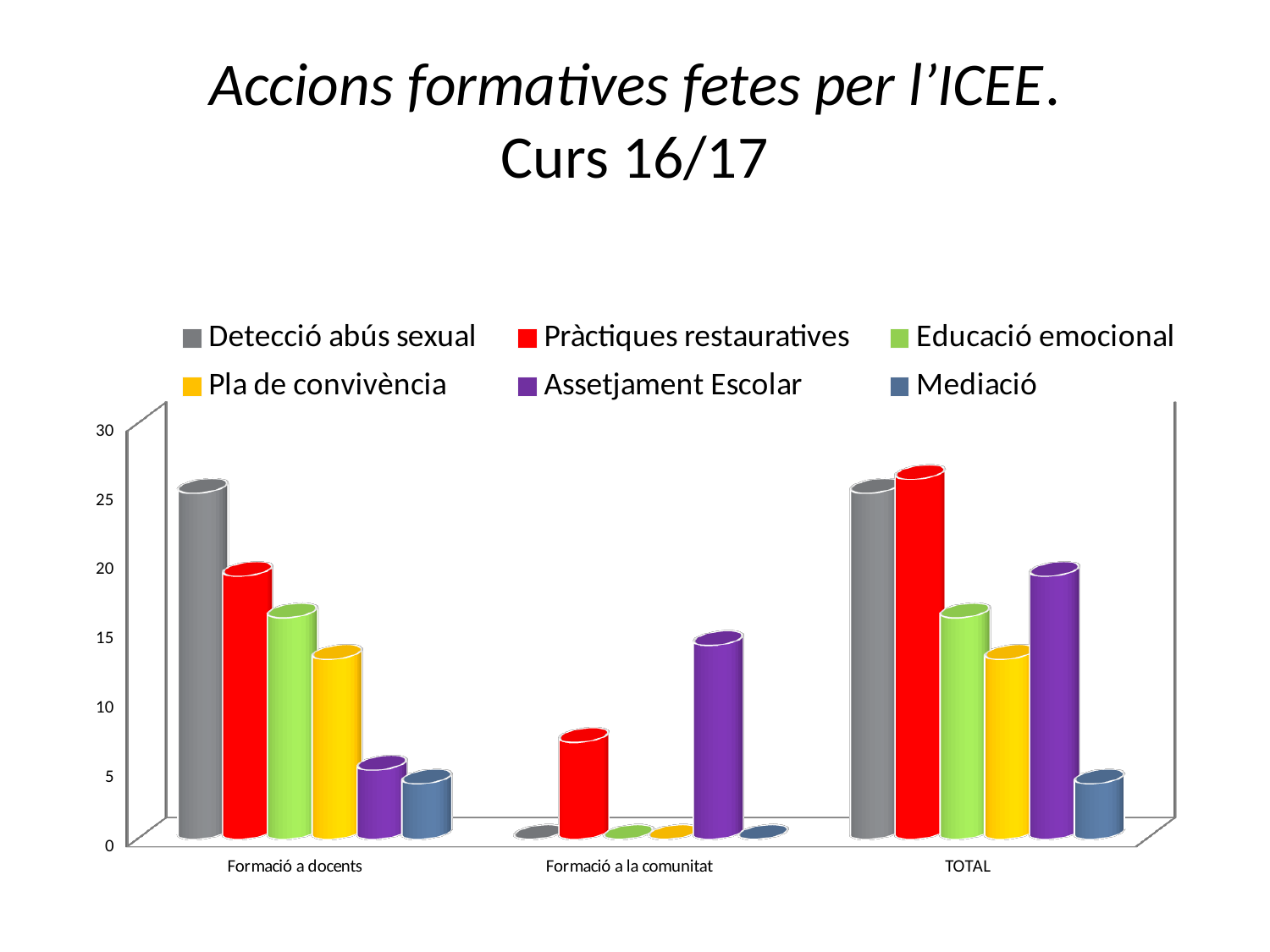
What kind of chart is shown on the slide? bar chart Is the value for Pràctiques restauratives in Formació a la comunitat greater or less than 10? less Which series has the highest value in the Formació a docents category? Detecció abús sexual Is the value for Pla de convivència in Formació a docents greater or less than 10? greater How many categories are shown on the x axis? 3 What is the title of the slide? Accions formatives fetes per l'ICEE. Curs 16/17 How many series does the legend list? 6 Which series has the highest value in the Formació a la comunitat category? Assetjament Escolar In the TOTAL category, which is larger: Assetjament Escolar or Educació emocional? Assetjament Escolar Is the value for Assetjament Escolar in Formació a la comunitat greater or less than 10? greater